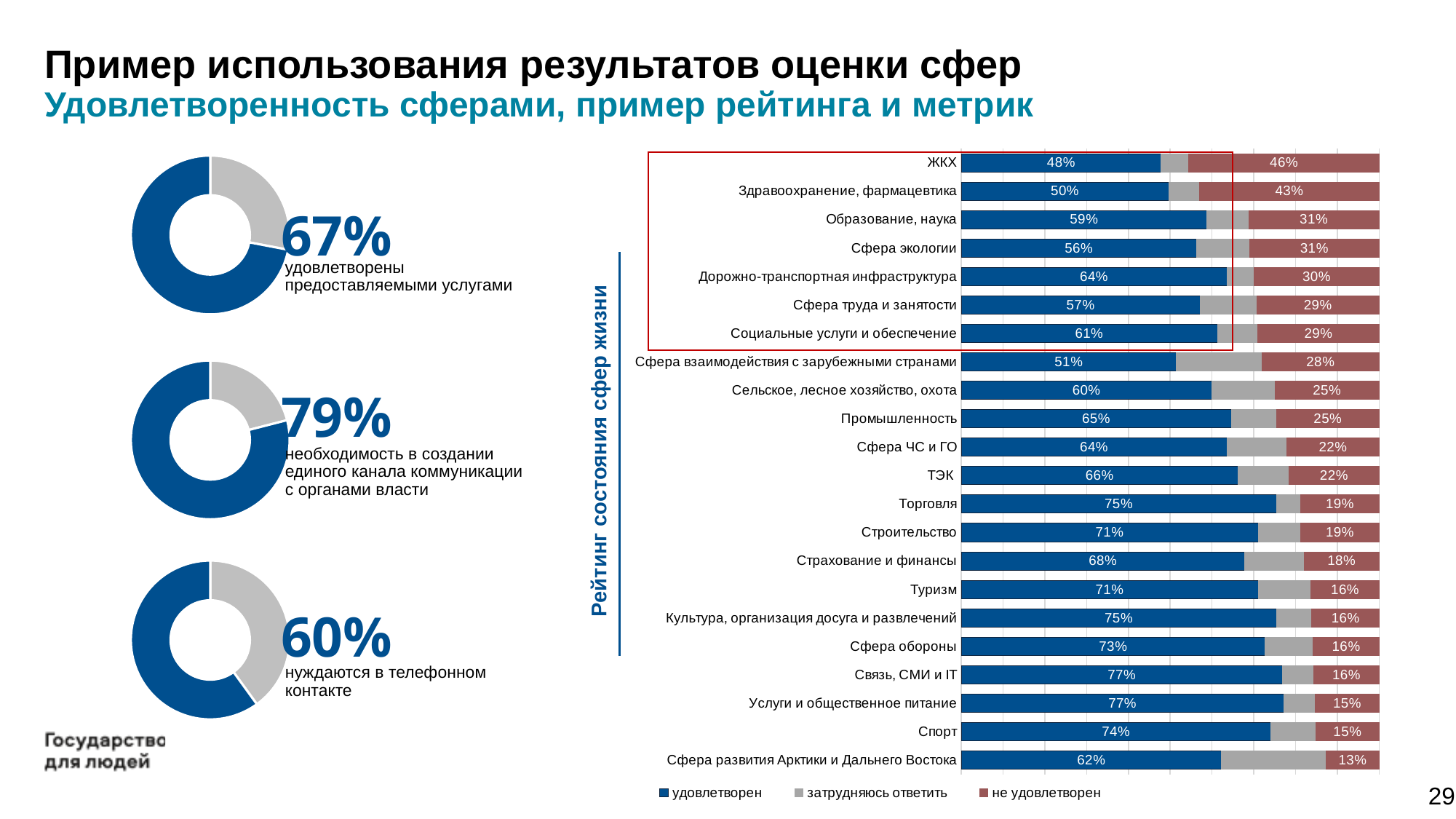
In the bar chart on the right, what is the difference between the 'удовлетворен' values for Торговля and Строительство? 4 percentage points In the bar chart on the right, which has a higher 'удовлетворен' value: Промышленность or Сельское, лесное хозяйство, охота? Промышленность In the bar chart on the right, which category has the lowest 'удовлетворен' value? ЖКХ In the bar chart on the right, which category has the highest 'не удовлетворен' value? ЖКХ In the bar chart on the right, what is the 'удовлетворен' value for Спорт? 74% What value is shown in the middle donut chart on the left of the slide? 79% In the bar chart on the right, what is the 'не удовлетворен' value for Образование, наука? 31% How many categories are shown in the bar chart on the right? 22 How many series does the legend of the bar chart on the right list? 3 What kind of chart is the large chart on the right side of the slide? bar chart In the bar chart on the right, which category has the lowest 'не удовлетворен' value? Сфера развития Арктики и Дальнего Востока In the bar chart on the right, what is the 'удовлетворен' value for ЖКХ? 48%